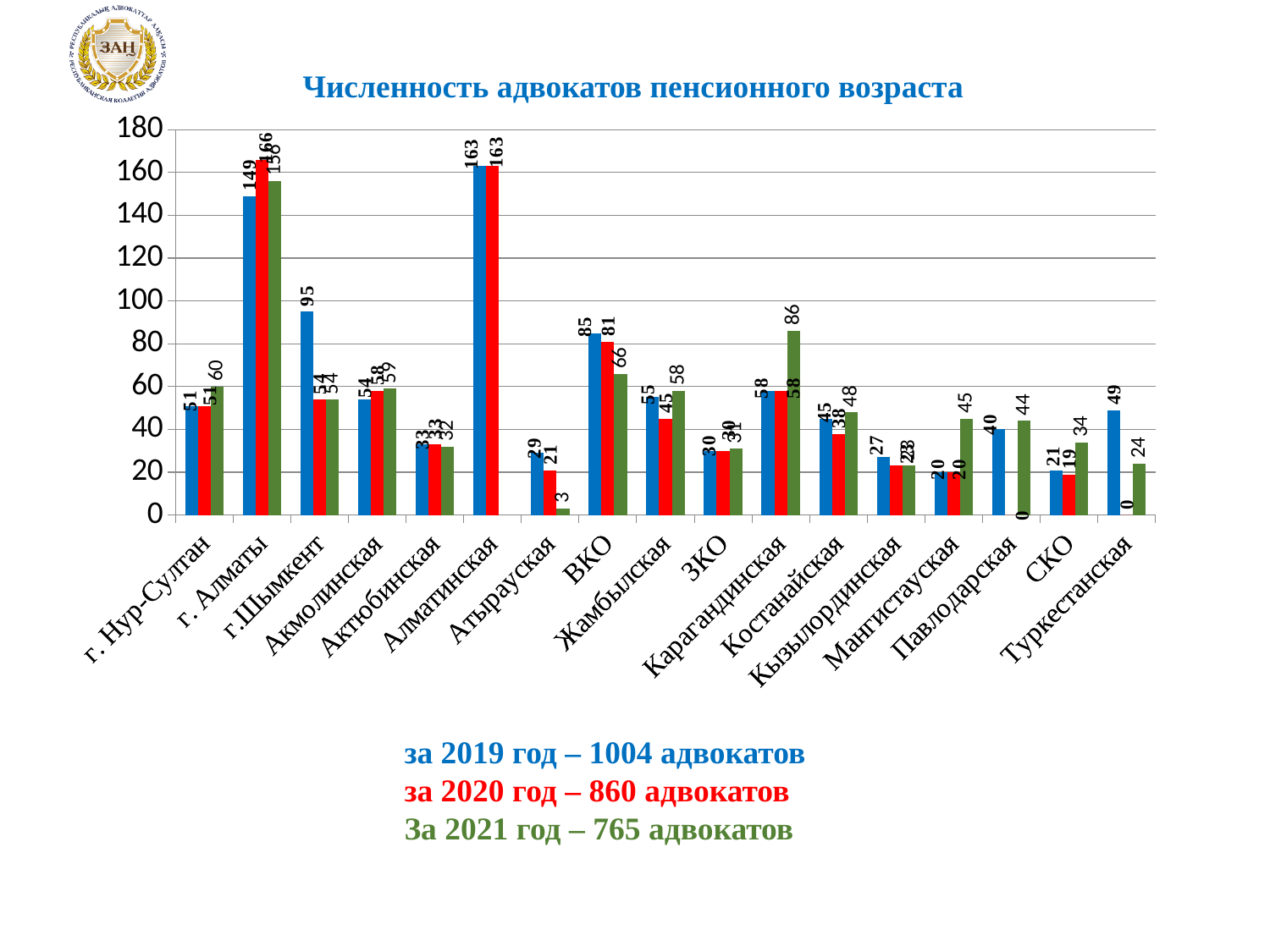
What is the difference between the blue (2019) and green (2021) bars for ВКО? 19 Which region has the highest blue (2019) bar? Алматинская Which is larger for Мангистауская: the blue (2019) bar or the green (2021) bar? green (2021) Which region has the lowest green (2021) bar among regions with a green bar? Атырауская What is the value of the blue (2019) bar for г. Шымкент? 95 How many regions (categories) are shown along the x axis of the chart? 17 What is the title of the chart? Численность адвокатов пенсионного возраста What is the value of the red (2020) bar for Павлодарская? 0 Is the value of the blue (2019) bar for г. Алматы greater or less than 140? greater What is the value of the red (2020) bar for г. Алматы? 166 What is the value of the green (2021) bar for Карагандинская? 86 What type of chart is shown on the slide? bar chart